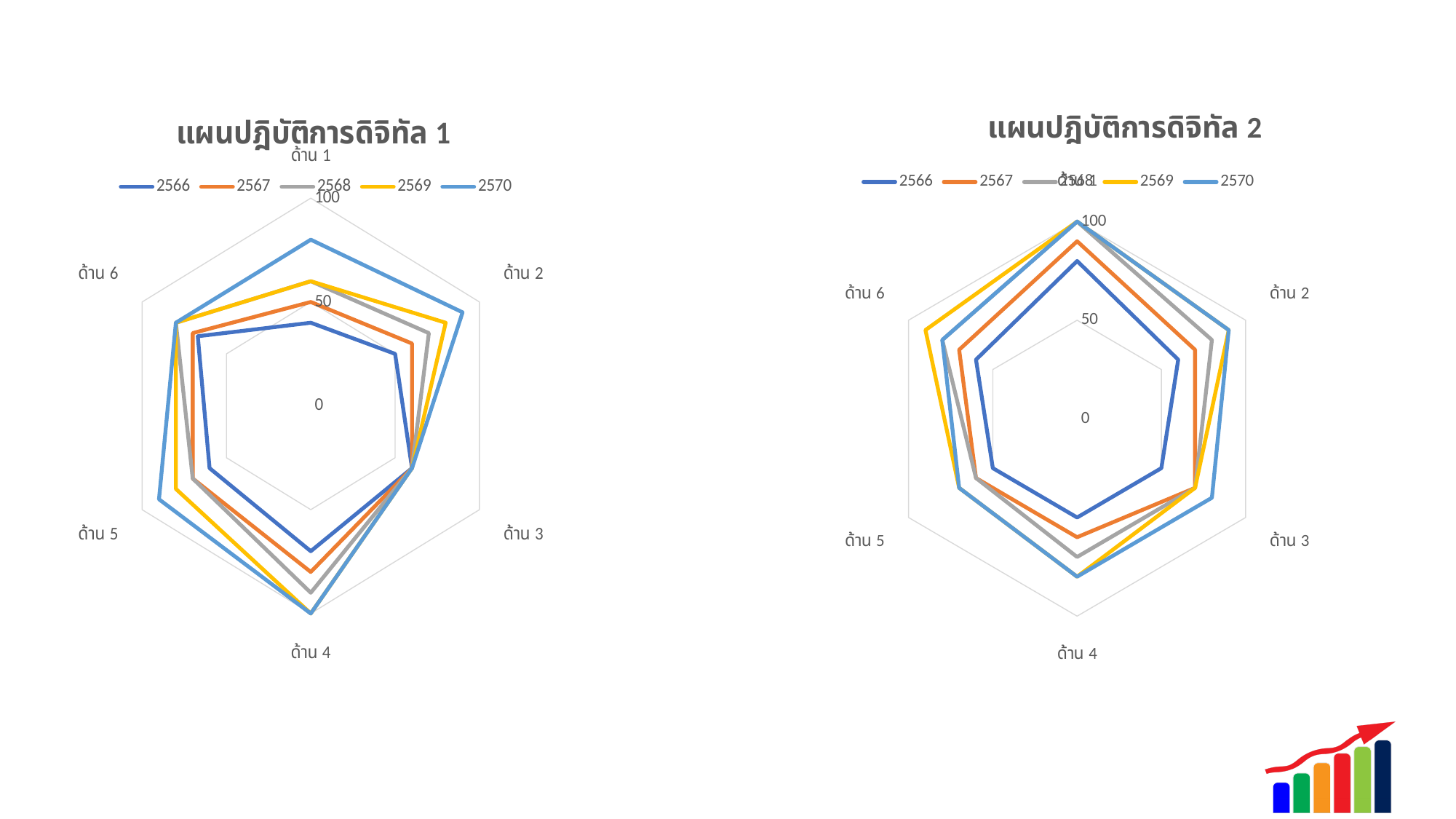
In the chart titled แผนปฏิบัติการดิจิทัล 1, is the value for 2570 at ด้าน 1 greater or less than 50? greater In the chart titled แผนปฏิบัติการดิจิทัล 2, is the value for 2570 at ด้าน 1 greater or less than 50? greater In the chart titled แผนปฏิบัติการดิจิทัล 2, how many categories (axes) are plotted? 6 In the chart titled แผนปฏิบัติการดิจิทัล 2, what is the highest value shown on the axis scale? 100 In the chart titled แผนปฏิบัติการดิจิทัล 2, which is larger at ด้าน 4: the value for 2570 or the value for 2566? 2570 In the chart titled แผนปฏิบัติการดิจิทัล 2, is the value for 2570 at ด้าน 4 greater or less than 50? greater In the chart titled แผนปฏิบัติการดิจิทัล 1, how many series does the legend list? 5 What is the title of the chart on the right side of the slide? แผนปฎิบัติการดิจิทัล 2 What kind of chart is the chart titled แผนปฏิบัติการดิจิทัล 1? radar chart In the chart titled แผนปฏิบัติการดิจิทัล 1, which is larger at ด้าน 1: the value for 2570 or the value for 2566? 2570